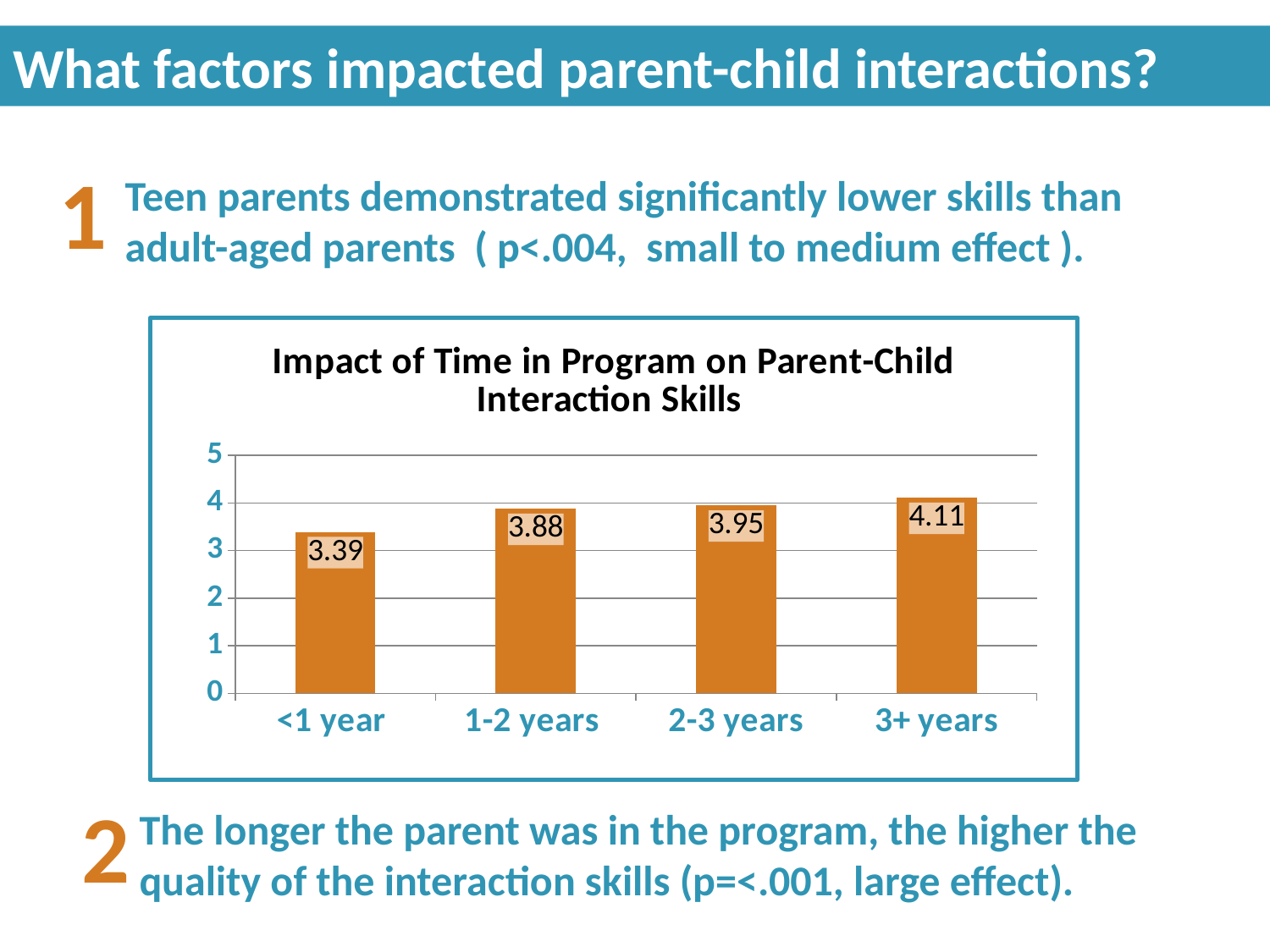
What is the value for 3+ years? 4.11 What is the difference between the values for 3+ years and <1 year? 0.72 Which category has the highest value? 3+ years What kind of chart is shown? bar chart Which category has the lowest value? <1 year What is the value for 2-3 years? 3.95 Do the values rise or fall from <1 year to 3+ years? rise Is the value for 3+ years greater or less than 4? greater How many categories are shown on the x axis? 4 What is the value for 1-2 years? 3.88 What is the value for <1 year? 3.39 Which is larger, the value for 1-2 years or the value for <1 year? 1-2 years